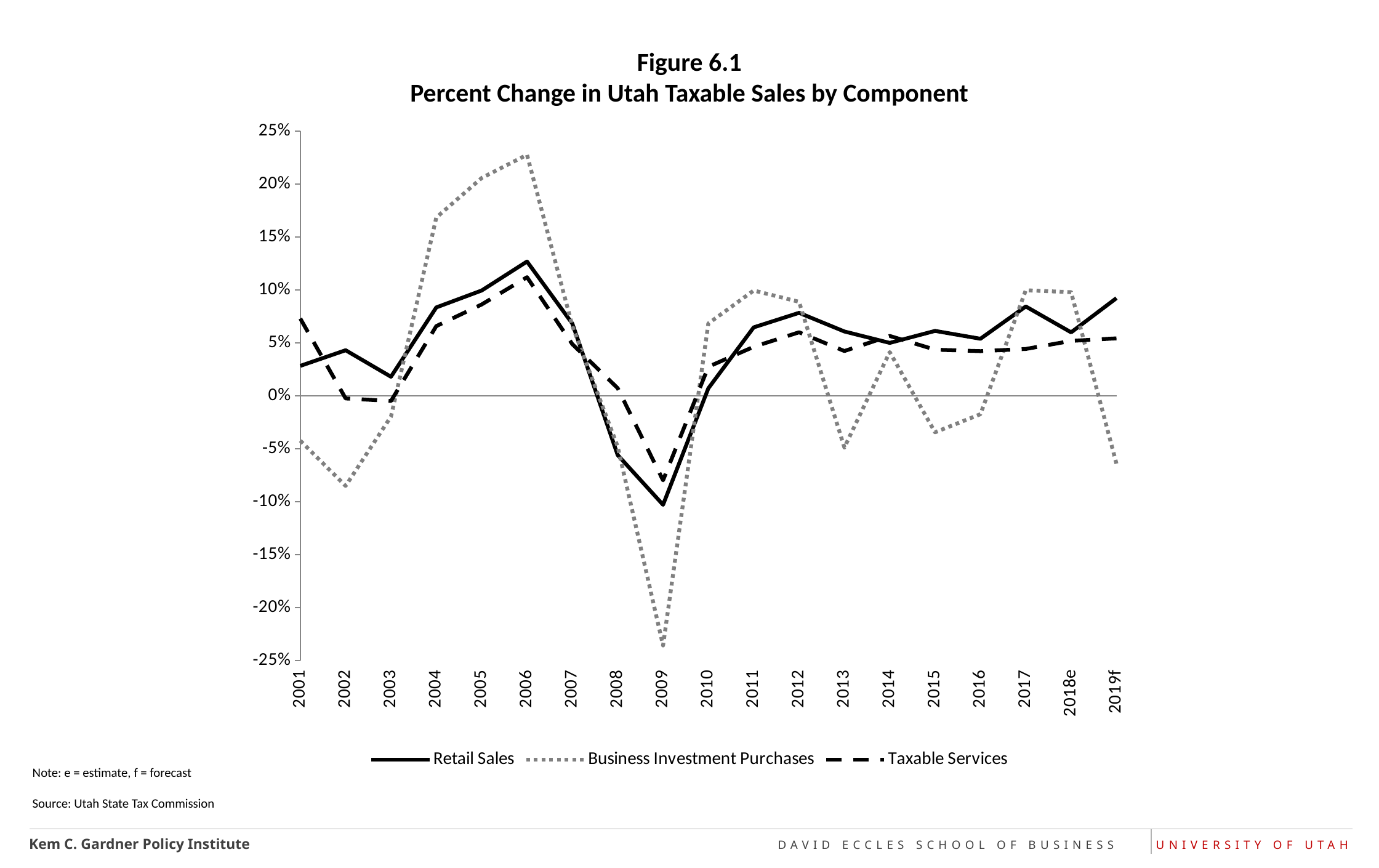
Does Retail Sales rise or fall from 2007 to 2009? Fall Is the value for Retail Sales in 2006 greater or less than 10%? greater Is the value for Business Investment Purchases in 2009 greater or less than -20%? less In 2009, which is higher: Retail Sales or Taxable Services? Taxable Services How many years are shown along the x axis? 19 In which year does Business Investment Purchases reach its highest value? 2006 In which year does Business Investment Purchases reach its lowest value? 2009 What kind of chart is shown on the slide? Line chart In which year does Retail Sales reach its highest value? 2006 How many series does the legend list? 3 What source is cited for the chart? Utah State Tax Commission In which year does Retail Sales reach its lowest value? 2009